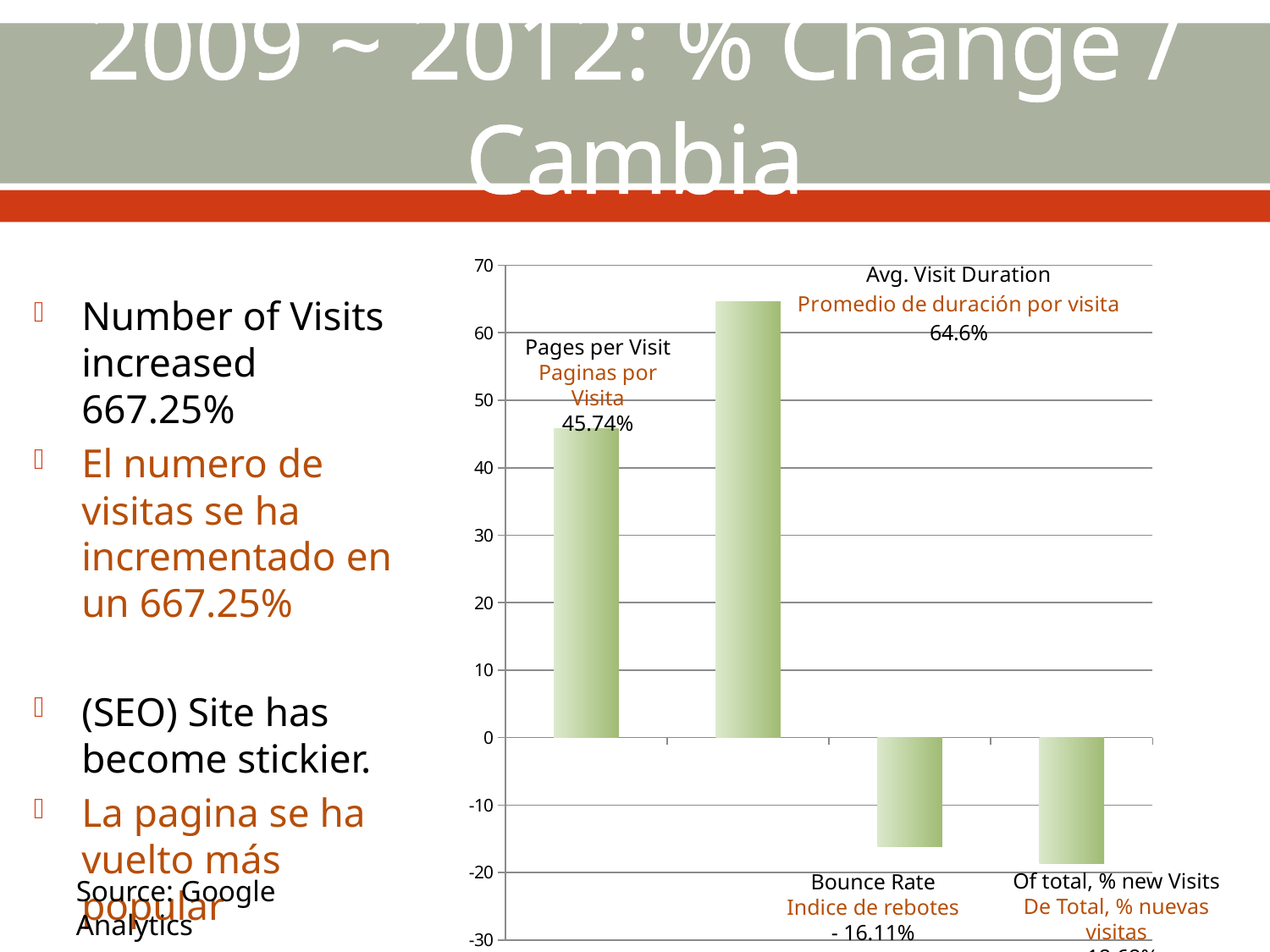
Which is larger, the value for Pages per Visit or the value for Bounce Rate? Pages per Visit What is the value shown for Avg. Visit Duration? 64.6% Which category has the lowest value in the chart? Of total, % new Visits Is the value for Avg. Visit Duration greater or less than 60? greater What kind of chart is shown on the slide? bar chart How many categories are plotted in the chart? 4 Which category has the highest value in the chart? Avg. Visit Duration How many bars in the chart have negative values? 2 What is the value shown for Pages per Visit? 45.74% Is the value for Of total, % new Visits greater or less than -10? less What is the value shown for Bounce Rate? - 16.11% What is the difference between the values for Avg. Visit Duration and Pages per Visit? 18.86%